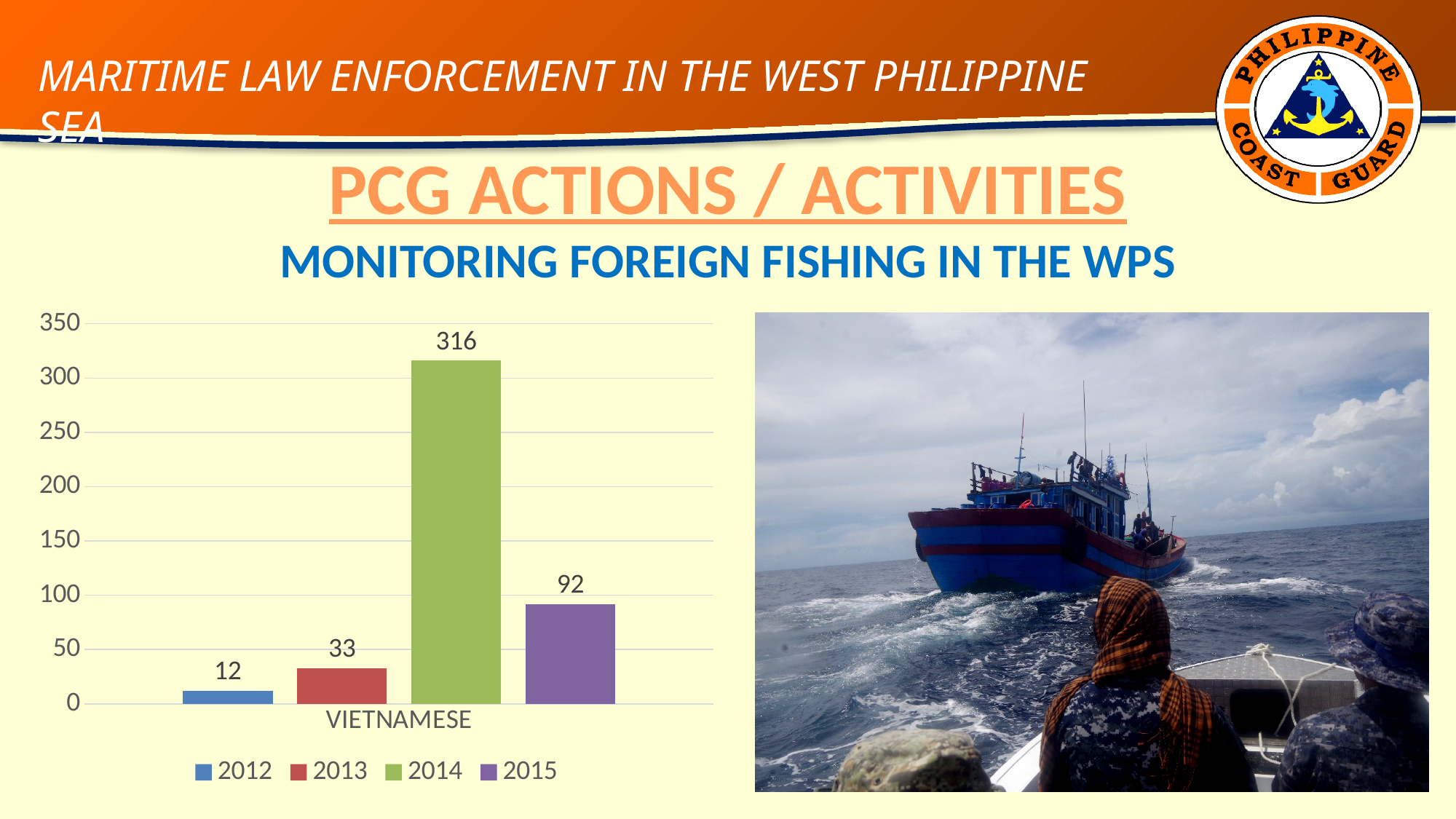
What is the value for 2012 in the Vietnamese category? 12 What is the value for 2015 in the Vietnamese category? 92 What is the value for 2014 in the Vietnamese category? 316 What kind of chart is shown on the slide? bar chart Which year has the highest value? 2014 What is the difference between the 2014 and 2015 values? 224 Is the value for 2015 greater or less than 100? less What is the category label shown on the x axis of the chart? VIETNAMESE Which is larger, the value for 2013 or the value for 2015? 2015 What is the difference between the 2013 and 2012 values? 21 How many series does the legend list? 4 Which year has the lowest value? 2012